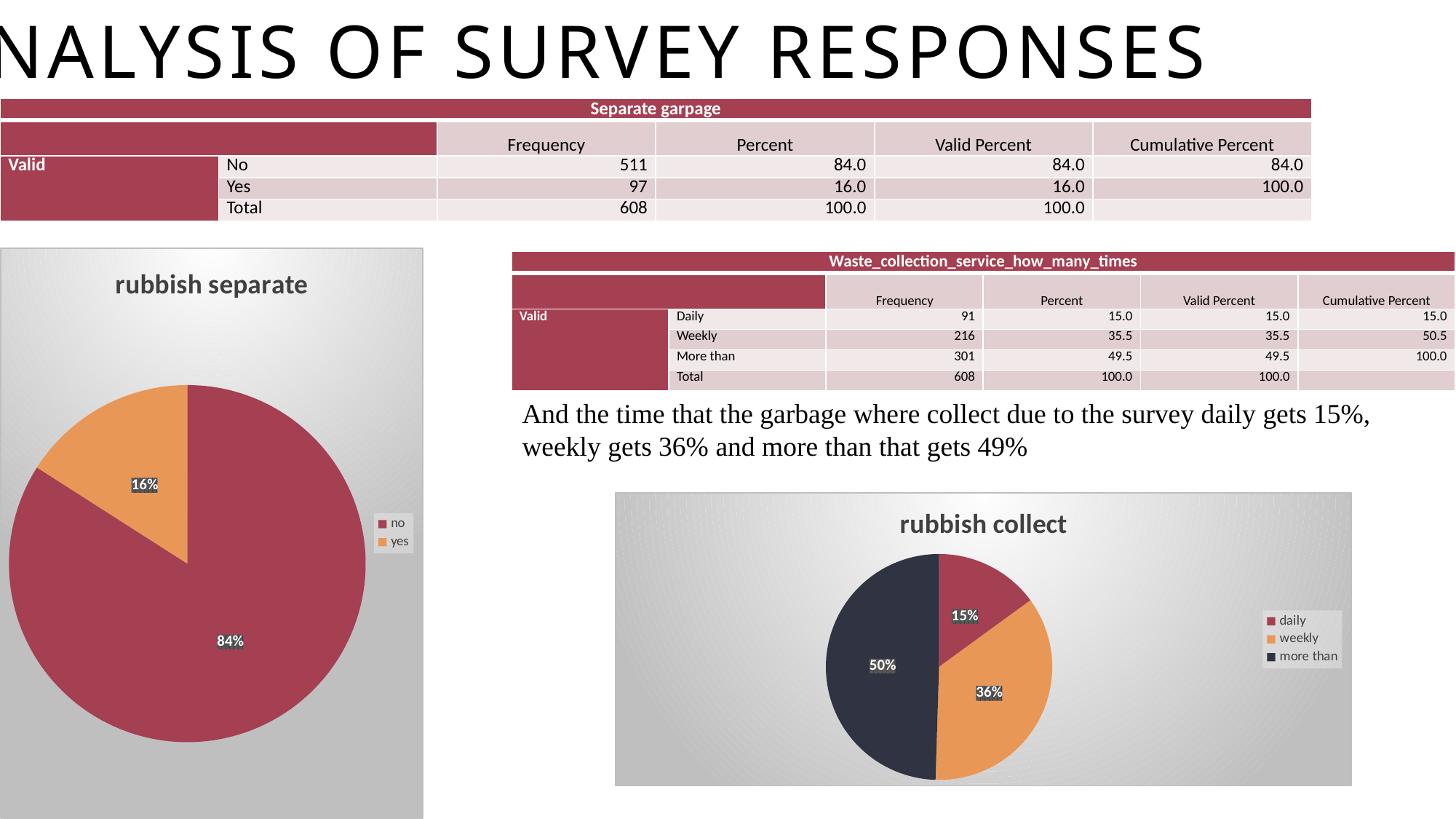
What kind of chart is the 'rubbish separate' chart? pie chart In the 'rubbish collect' chart, what is the difference in percentage points between the 'more than' slice and the 'weekly' slice? 14 In the 'rubbish separate' chart, which slice is the largest? no In the 'rubbish separate' chart, what share of the pie is labelled 'yes'? 16% In the 'rubbish collect' chart, how many entries does the legend list? 3 In the 'rubbish collect' chart, which is larger, the 'weekly' slice or the 'daily' slice? weekly In the 'rubbish separate' chart, what share of the pie is labelled 'no'? 84% In the 'rubbish collect' chart, what share of the pie is labelled 'weekly'? 36% In the 'rubbish separate' chart, how many slices does the pie have? 2 In the 'rubbish collect' chart, which slice is the smallest? daily